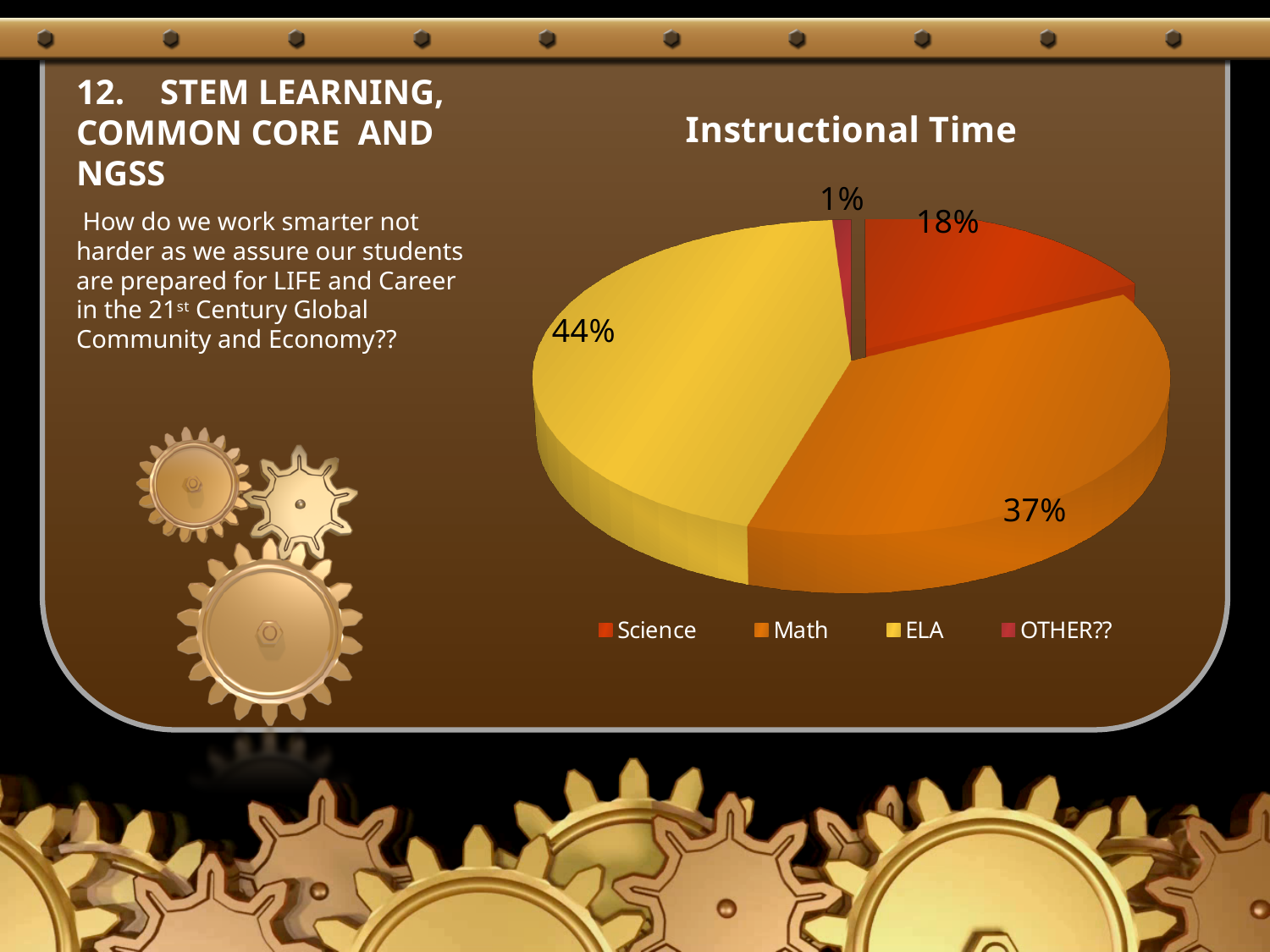
What is the title of the chart? Instructional Time What share of instructional time does Math take? 37% What share of instructional time does ELA take? 44% What colour is the ELA slice in the pie chart? yellow Which has a larger share of instructional time, Math or Science? Math What is the difference in percentage points between the ELA share and the Science share? 26% How many categories does the legend list? 4 Which category has the largest share of instructional time? ELA What share of instructional time does Science take? 18% Which category has the smallest share of instructional time? OTHER?? What kind of chart is shown on the slide? pie chart